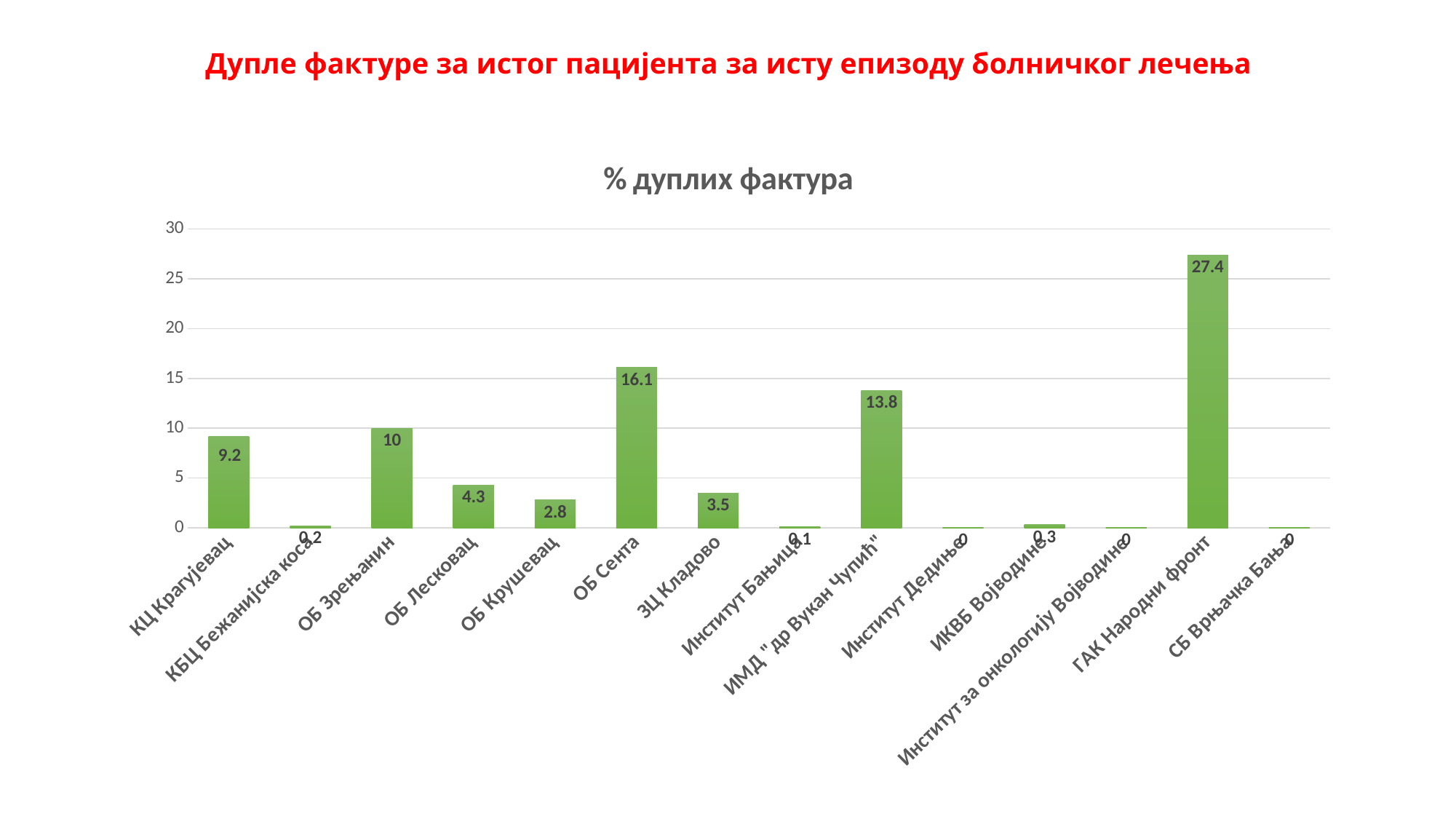
What is the value for ОБ Зрењанин? 10 What is the value for ГАК Народни фронт? 27.4 Which is larger, the value for ОБ Крушевац or the value for ЗЦ Кладово? ЗЦ Кладово What is the title of the chart? % дуплих фактура Is the value for ГАК Народни фронт greater or less than 25? greater Which category has the highest value? ГАК Народни фронт What is the value for ЗЦ Кладово? 3.5 What is the value for ОБ Сента? 16.1 What is the difference between the values for КЦ Крагујевац and ОБ Лесковац? 4.9 What is the difference between the values for ОБ Сента and ИМД "др Вукан Чупић"? 2.3 How many categories are shown on the x axis? 14 What kind of chart is shown on the slide? bar chart